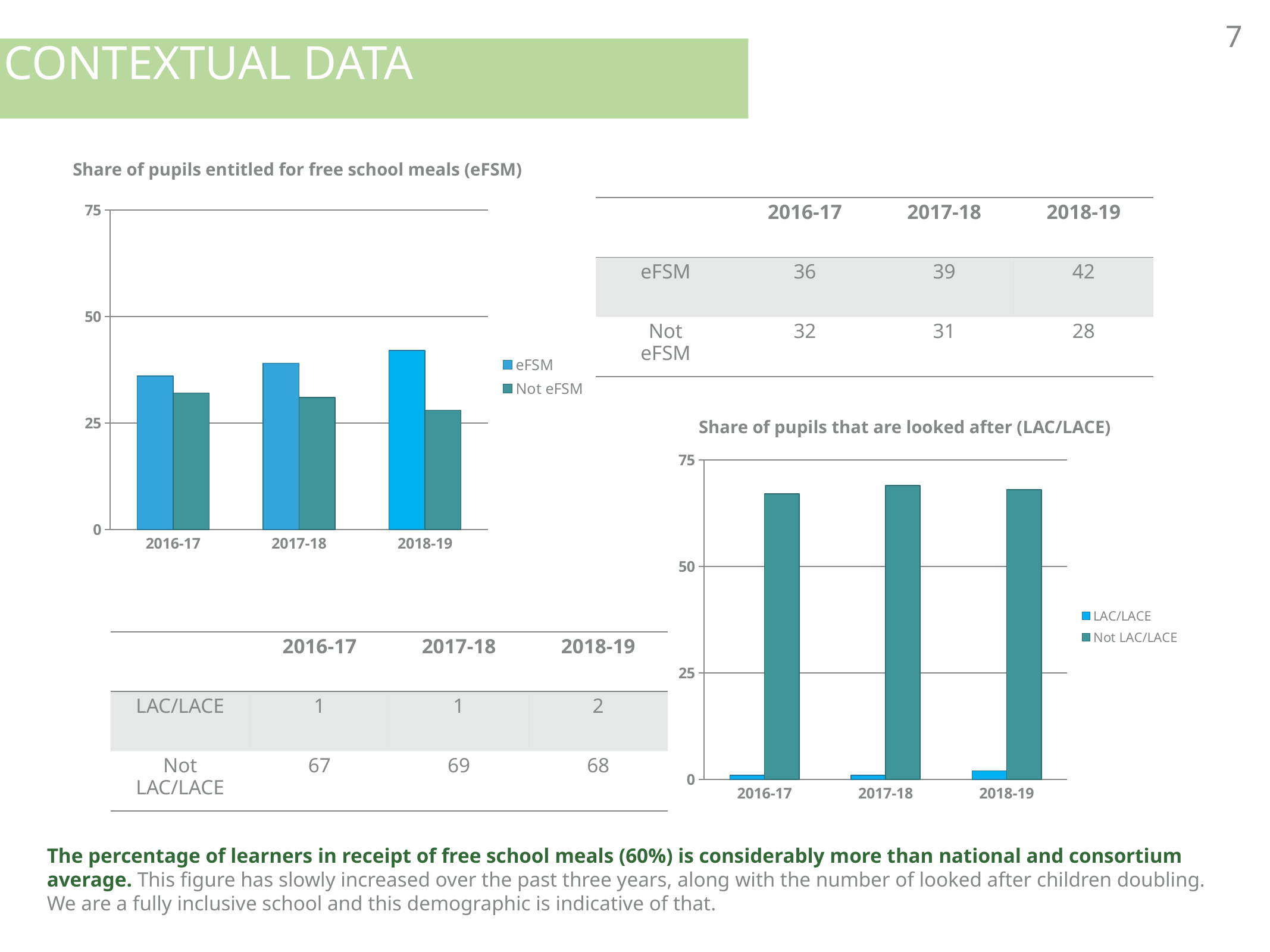
What kind of chart is the one titled 'Share of pupils that are looked after (LAC/LACE)'? bar chart In the chart titled 'Share of pupils that are looked after (LAC/LACE)', what is the LAC/LACE value for 2018-19? 2 In the chart titled 'Share of pupils that are looked after (LAC/LACE)', what is the Not LAC/LACE value for 2017-18? 69 In the chart titled 'Share of pupils entitled for free school meals (eFSM)', what is the eFSM value for 2018-19? 42 In the chart titled 'Share of pupils entitled for free school meals (eFSM)', which year has the highest eFSM value? 2018-19 In the chart titled 'Share of pupils entitled for free school meals (eFSM)', which year has the lowest Not eFSM value? 2018-19 In the chart titled 'Share of pupils entitled for free school meals (eFSM)', what is the Not eFSM value for 2016-17? 32 In the chart titled 'Share of pupils entitled for free school meals (eFSM)', does the eFSM series rise or fall from 2016-17 to 2018-19? rise In the chart titled 'Share of pupils entitled for free school meals (eFSM)', how many series does the legend list? 2 In the chart titled 'Share of pupils that are looked after (LAC/LACE)', how many years are shown on the x axis? 3 In the chart titled 'Share of pupils that are looked after (LAC/LACE)', is the Not LAC/LACE value for 2016-17 greater or less than 50? greater In the chart titled 'Share of pupils entitled for free school meals (eFSM)', what is the difference between the eFSM and Not eFSM values for 2018-19? 14